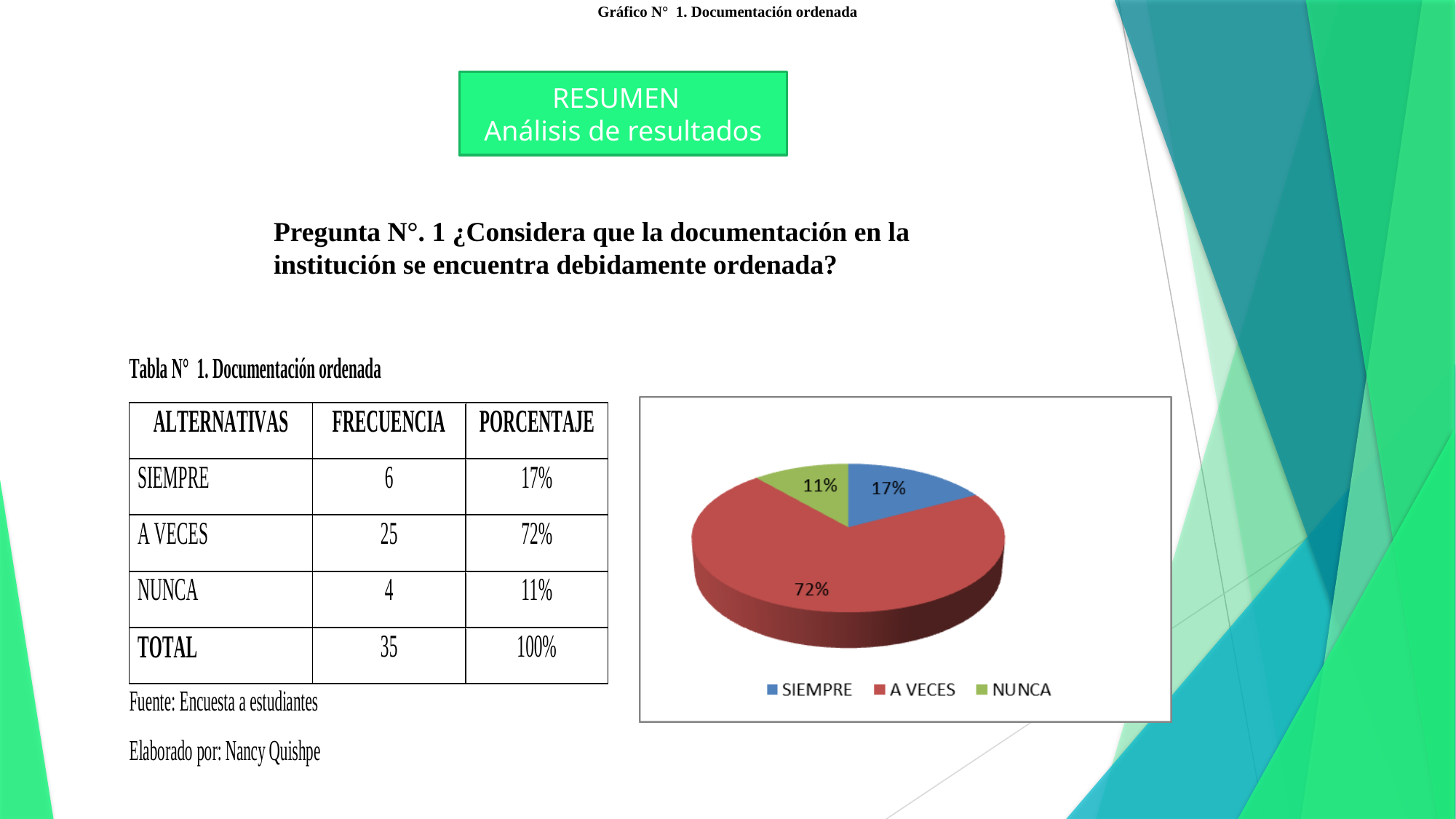
How many entries does the legend of the pie chart list? 3 What percentage does the A VECES slice show in the pie chart? 72% How many slices does the pie chart have? 3 What percentage does the NUNCA slice show in the pie chart? 11% Which slice is larger in the pie chart, SIEMPRE or NUNCA? SIEMPRE Which category has the smallest slice in the pie chart? NUNCA What is the difference in percentage points between the A VECES slice and the SIEMPRE slice? 55 What kind of chart is shown on the slide? pie chart What colour is the A VECES slice in the pie chart? red What is the title of the chart given at the top of the slide? Gráfico N° 1. Documentación ordenada What percentage does the SIEMPRE slice show in the pie chart? 17% Which category has the largest slice in the pie chart? A VECES